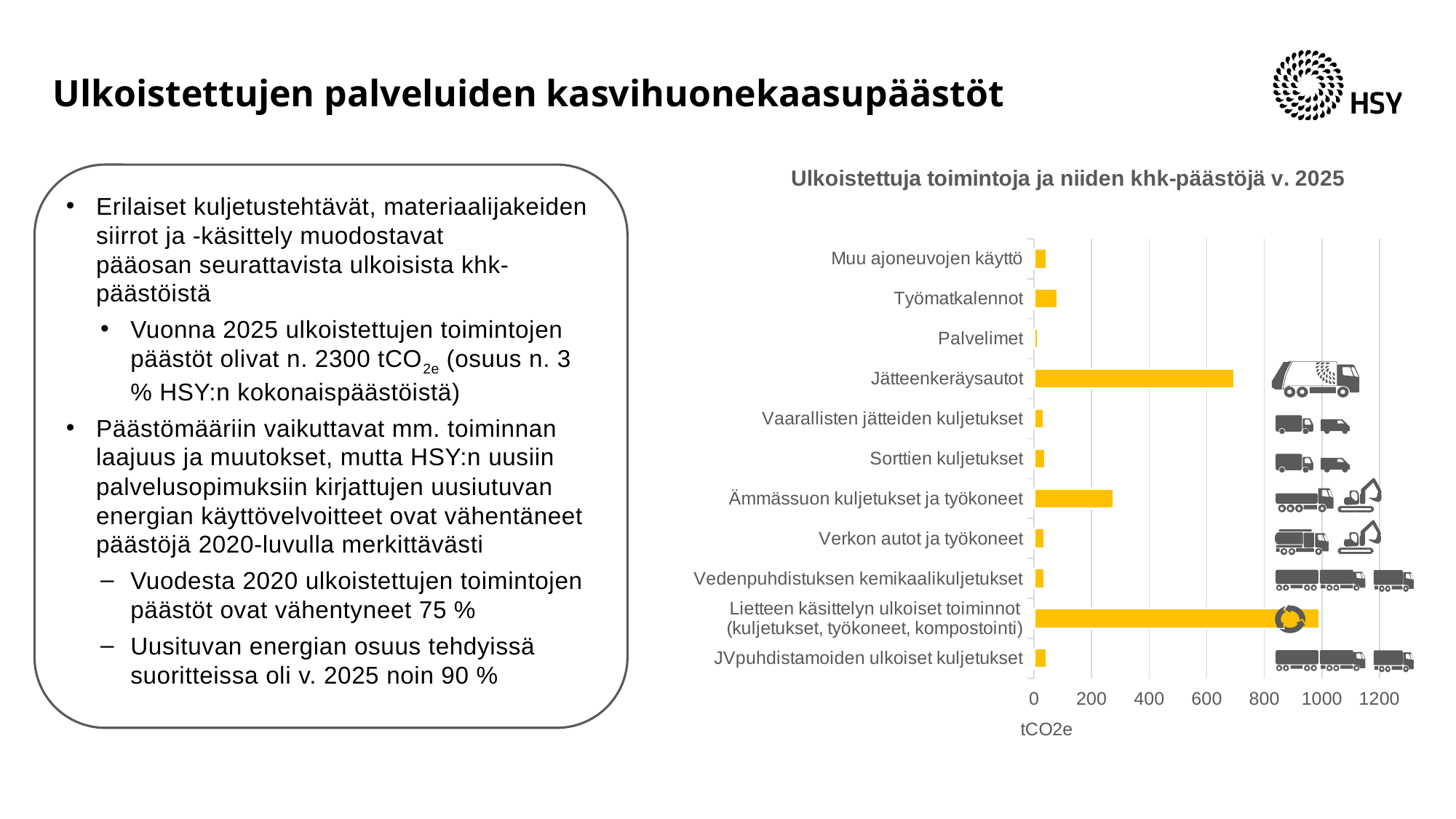
What is the title of the chart? Ulkoistettuja toimintoja ja niiden khk-päästöjä v. 2025 Which has higher emissions, Työmatkalennot or Muu ajoneuvojen käyttö? Työmatkalennot Which category has the lowest emissions in the chart? Palvelimet Is the value for Työmatkalennot greater or less than 200? less Which has higher emissions, Jätteenkeräysautot or Ämmässuon kuljetukset ja työkoneet? Jätteenkeräysautot Is the value for Lietteen käsittelyn ulkoiset toiminnot greater or less than 800? greater What unit is shown on the horizontal axis of the chart? tCO2e Which category has the highest emissions in the chart? Lietteen käsittelyn ulkoiset toiminnot (kuljetukset, työkoneet, kompostointi) How many categories are plotted in the chart? 11 Is the value for Ämmässuon kuljetukset ja työkoneet greater or less than 400? less What kind of chart is shown on the slide? bar chart